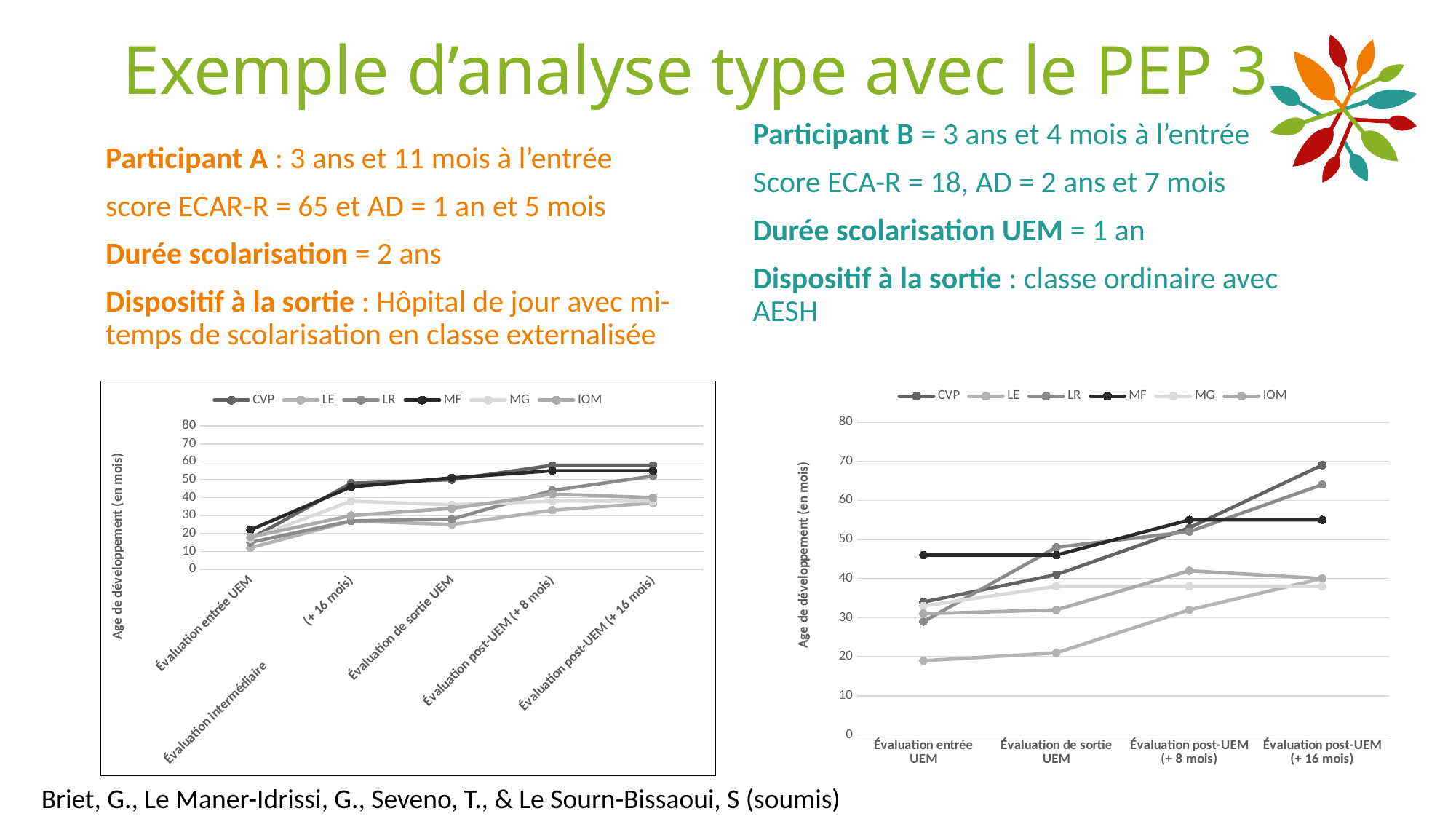
What kind of chart is the left chart (Participant A)? line chart In the right chart (Participant B), does the CVP series rise or fall from 'Évaluation entrée UEM' to 'Évaluation post-UEM (+ 16 mois)'? rise What is the y-axis label of the left chart (Participant A)? Age de développement (en mois) In the right chart (Participant B), is the value for CVP at 'Évaluation post-UEM (+ 16 mois)' greater or less than 60? greater How many evaluation points are shown on the x axis of the right chart (Participant B)? 4 How many series does the legend of the right chart (Participant B) list? 6 In the right chart (Participant B), is the value for LE at 'Évaluation entrée UEM' greater or less than 30? less Which series are listed in the legend of the left chart (Participant A)? CVP, LE, LR, MF, MG, IOM How many evaluation points are shown on the x axis of the left chart (Participant A)? 5 In the right chart (Participant B), at 'Évaluation post-UEM (+ 16 mois)', which is larger: CVP or LE? CVP In the right chart (Participant B), is the value for MF at 'Évaluation entrée UEM' greater or less than 40? greater